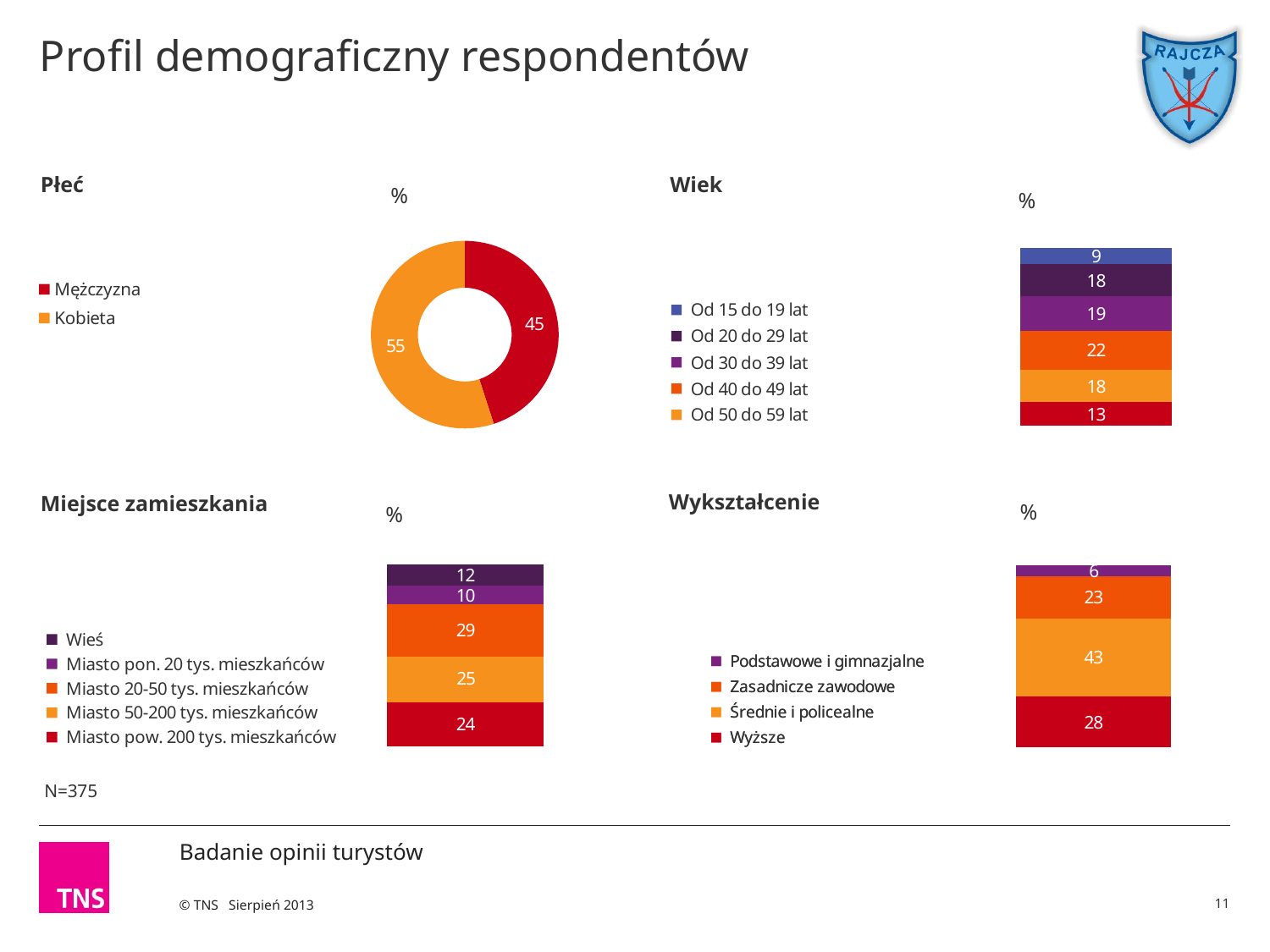
What kind of chart is the Płeć chart? Donut (pie) chart In the Płeć chart, what is the value for Mężczyzna? 45 In the Wiek chart, which of the labelled age groups has the highest value? Od 40 do 49 lat In the Miejsce zamieszkania chart, what is the value for Miasto 20-50 tys. mieszkańców? 29 How many series does the legend of the Wiek chart list? 5 In the Wykształcenie chart, what is the value for Średnie i policealne? 43 In the Wiek chart, what is the value for Od 15 do 19 lat? 9 In the Miejsce zamieszkania chart, which category has the lowest value? Miasto pon. 20 tys. mieszkańców In the Wykształcenie chart, which is larger: Zasadnicze zawodowe or Wyższe? Wyższe In the Płeć chart, what is the value for Kobieta? 55 In the Wiek chart, what is the value for Od 40 do 49 lat? 22 In the Miejsce zamieszkania chart, what is the difference between Miasto 50-200 tys. mieszkańców and Wieś? 13